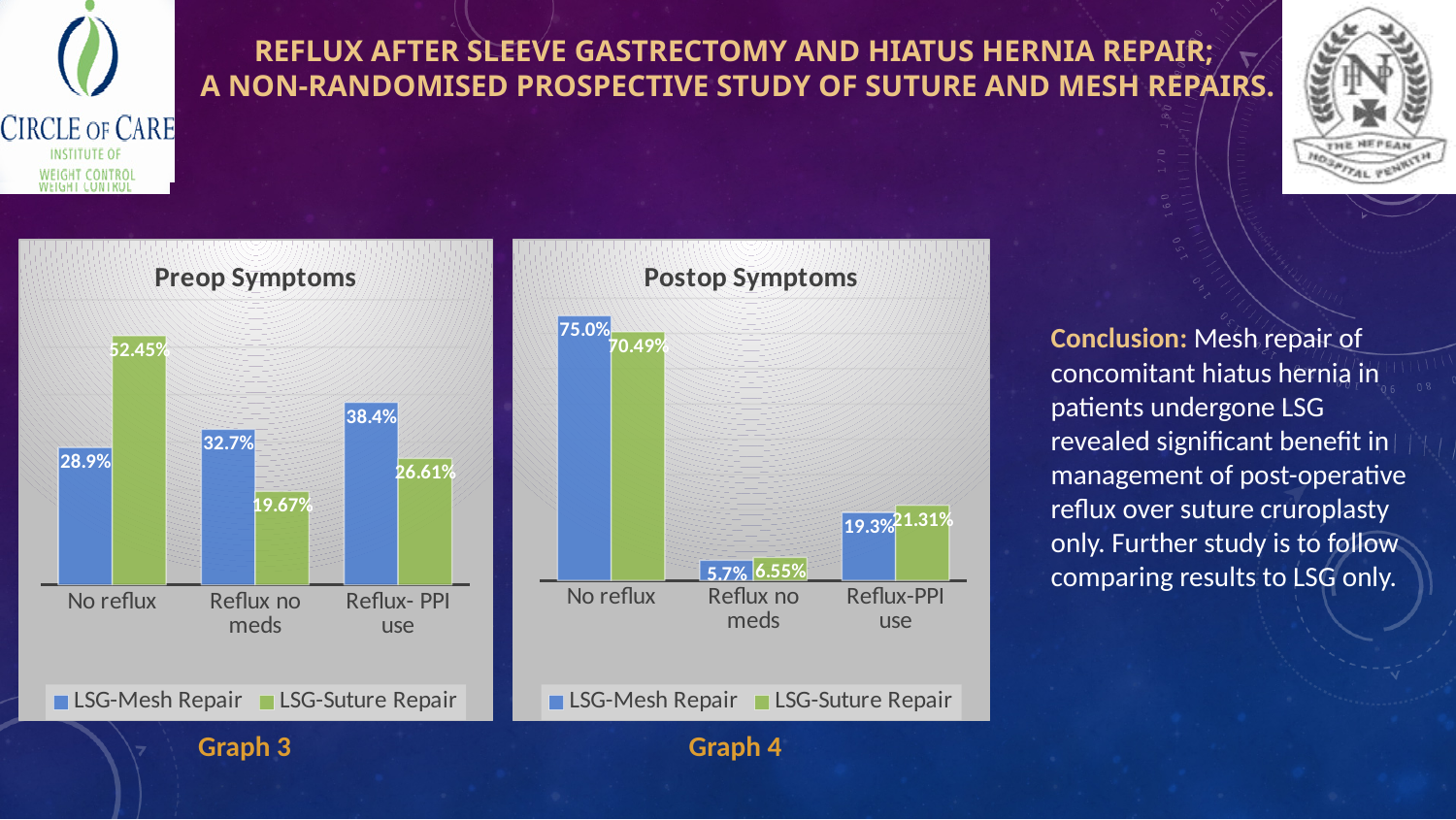
In the Preop Symptoms chart, what is the value for LSG-Mesh Repair in the Reflux- PPI use category? 38.4% How many categories are shown on the x axis of the Postop Symptoms chart? 3 In the Postop Symptoms chart, what is the value for LSG-Mesh Repair in the No reflux category? 75.0% In the Preop Symptoms chart, which category has the highest value for LSG-Mesh Repair? Reflux- PPI use In the Postop Symptoms chart, what is the difference between the LSG-Mesh Repair and LSG-Suture Repair values in the No reflux category? 4.51% In the Preop Symptoms chart, what is the difference between the LSG-Suture Repair and LSG-Mesh Repair values in the No reflux category? 23.55% In the Preop Symptoms chart, what is the value for LSG-Suture Repair in the No reflux category? 52.45% What type of chart is the Postop Symptoms chart? Bar chart In the Postop Symptoms chart, which category has the lowest value for LSG-Mesh Repair? Reflux no meds In the Preop Symptoms chart, which is larger in the Reflux no meds category: LSG-Mesh Repair or LSG-Suture Repair? LSG-Mesh Repair In the Postop Symptoms chart, what is the value for LSG-Suture Repair in the Reflux no meds category? 6.55% How many series does the legend of the Preop Symptoms chart list? 2